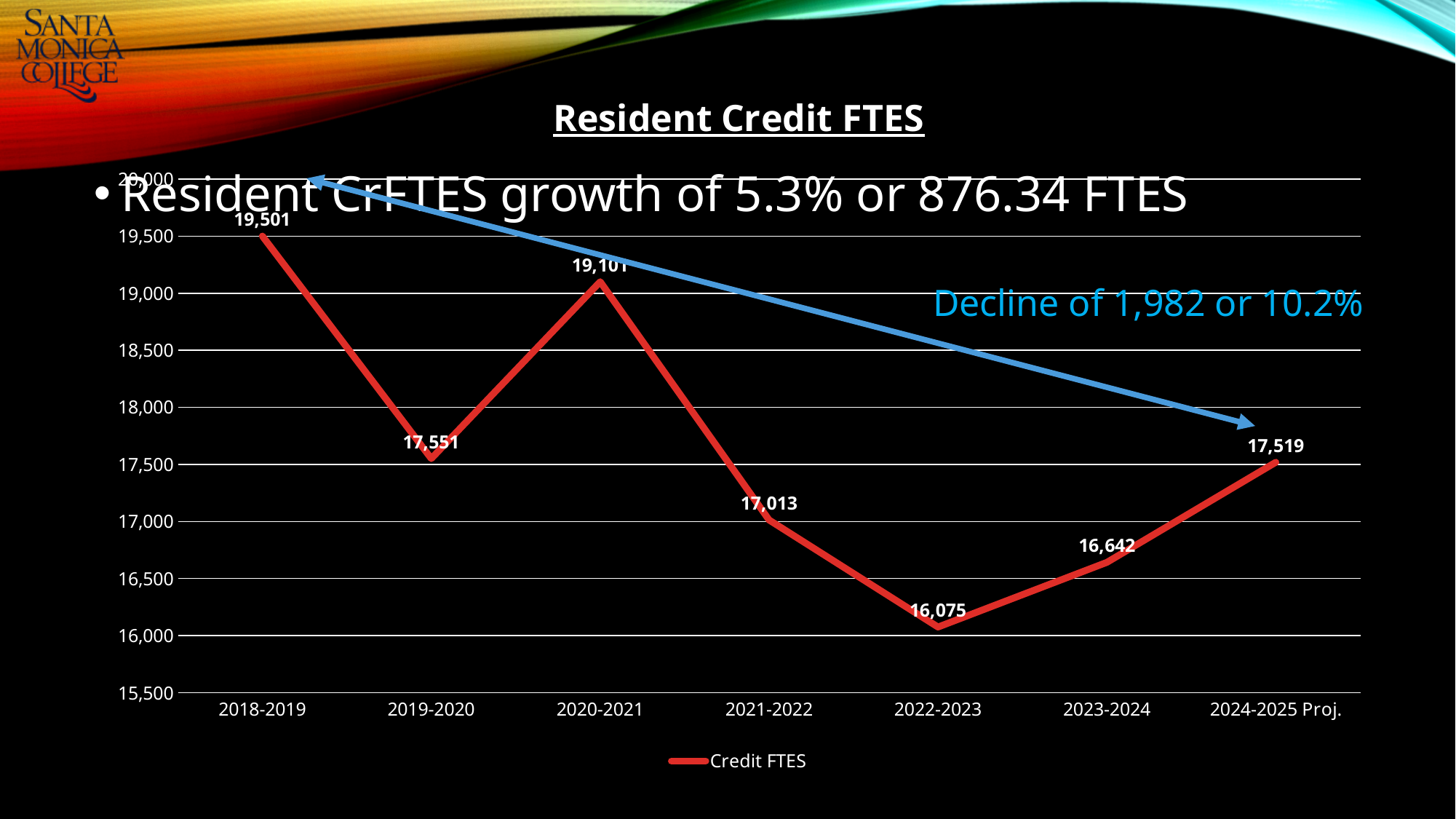
What is the Credit FTES value for 2022-2023? 16,075 What is the Credit FTES value for 2023-2024? 16,642 What is the difference between the Credit FTES values for 2018-2019 and 2019-2020? 1,950 How many series does the legend list? 1 How many years are plotted on the x axis? 7 Which is larger, the Credit FTES value for 2021-2022 or for 2024-2025 Proj.? 2024-2025 Proj. What is the Credit FTES value for 2024-2025 Proj.? 17,519 What is the Credit FTES value for 2018-2019? 19,501 What type of chart is shown on the slide? line chart Which year has the lowest Credit FTES value? 2022-2023 What is the title of the chart? Resident Credit FTES Which year has the highest Credit FTES value? 2018-2019